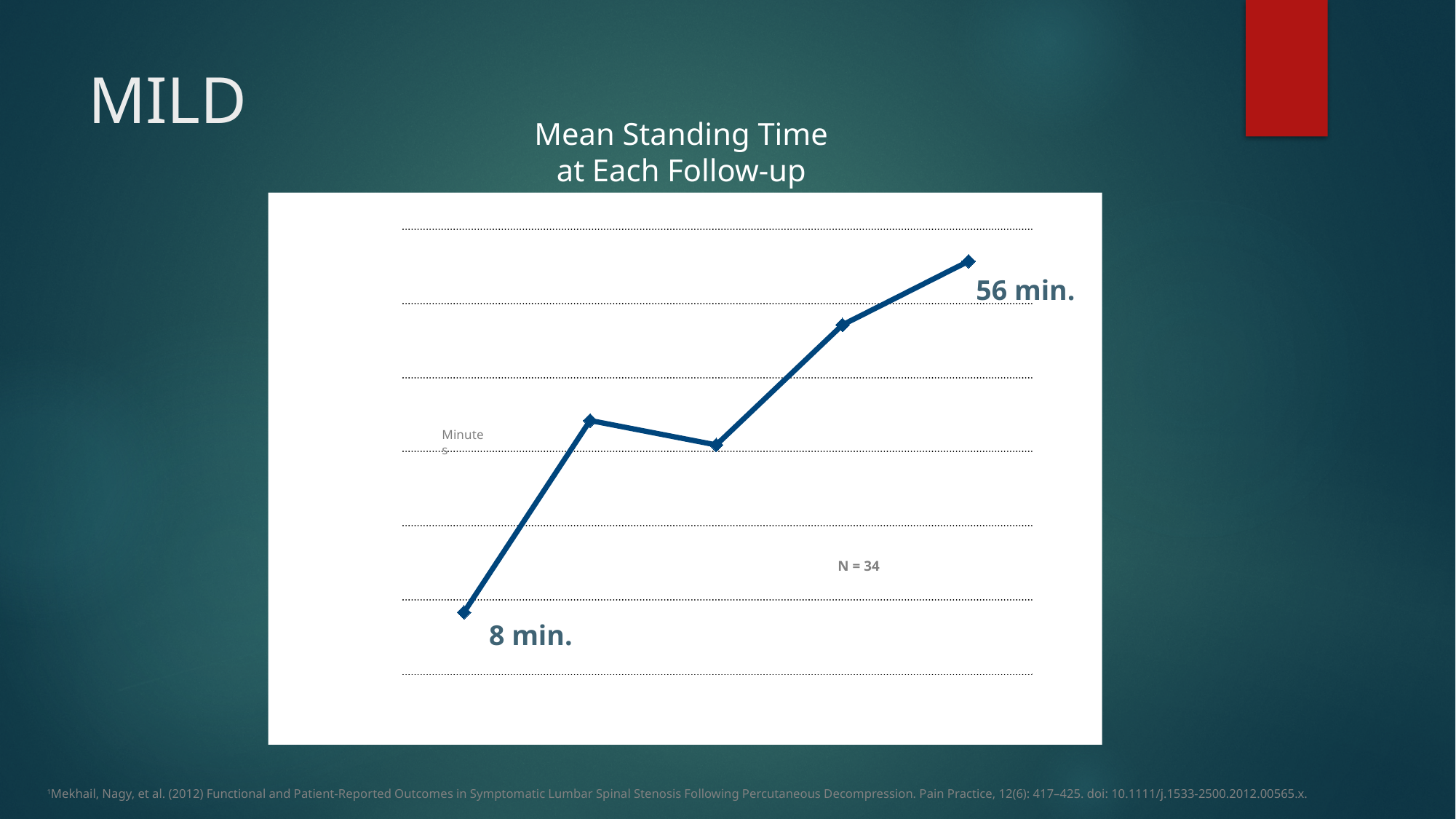
What kind of chart is shown on the slide? line chart Is the second point on the line higher or lower than the third point? higher What is the mean standing time at the first point on the chart? 8 min. What is the title of the chart? Mean Standing Time at Each Follow-up How many data points are plotted on the line? 5 Which point on the line has the highest mean standing time? the last point (56 min.) What sample size (N) is shown on the chart? N = 34 By how many minutes does the mean standing time at the last point exceed the first point? 48 min. Which point on the line has the lowest mean standing time? the first point (8 min.) What is the mean standing time at the last follow-up point on the chart? 56 min. Is the mean standing time at the last point larger or smaller than at the first point? larger Does the mean standing time generally rise or fall from the first point to the last point? rise